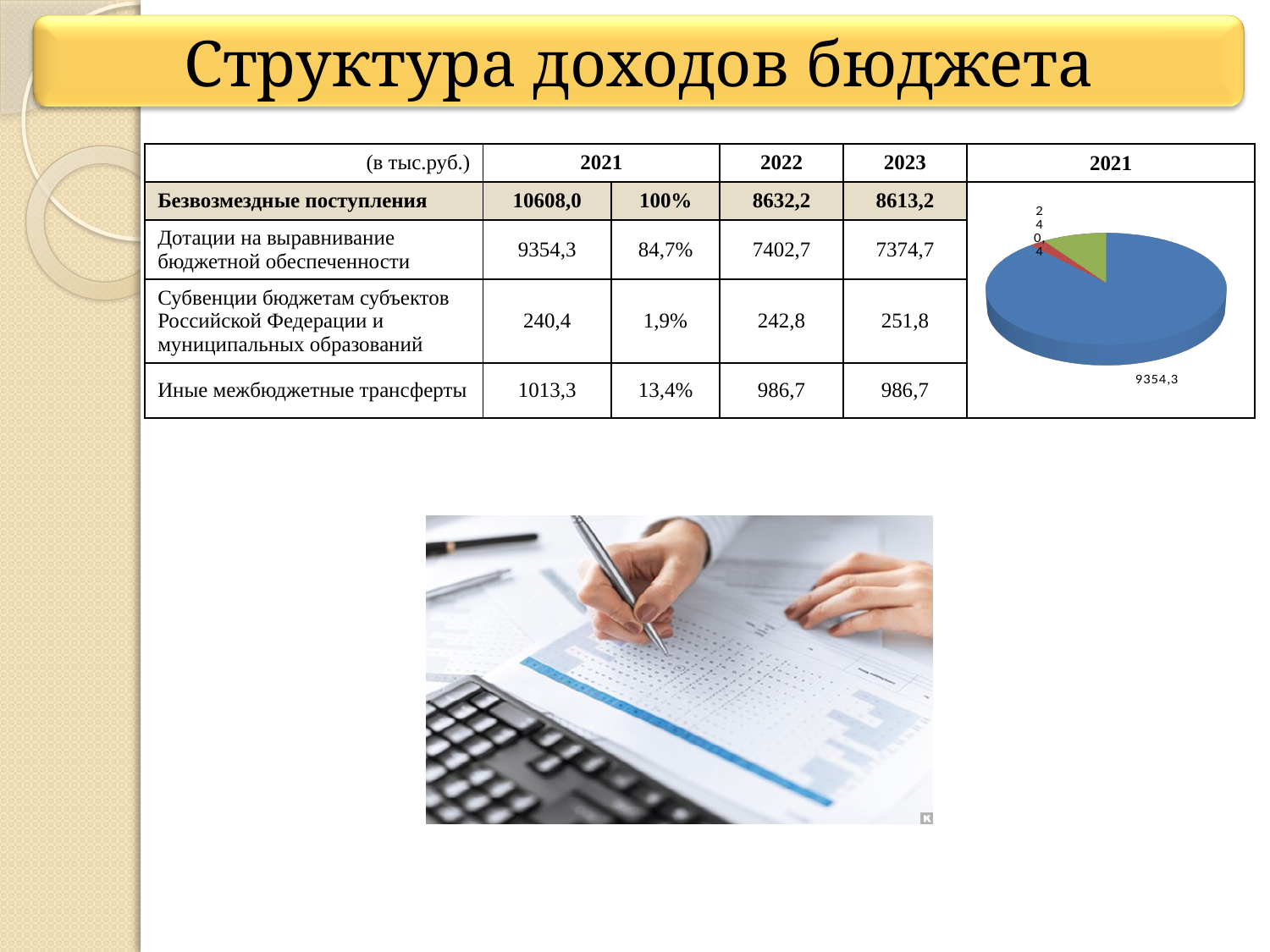
Which slice of the pie chart is larger, the blue one or the red one? the blue one What value is printed on the red slice of the pie chart? 240,4 What is the title of the pie chart? 2021 Is the value on the blue slice of the pie chart greater or less than 9000? greater What value is labelled on the largest slice of the pie chart? 9354,3 How many slices does the pie chart have? 3 What is the difference between the value on the blue slice and the value on the red slice of the pie chart? 9113,9 What kind of chart is shown on the slide? pie chart What value is printed on the blue slice of the pie chart? 9354,3 What colour is the largest slice of the pie chart? blue What value is labelled on the smallest slice of the pie chart? 240,4